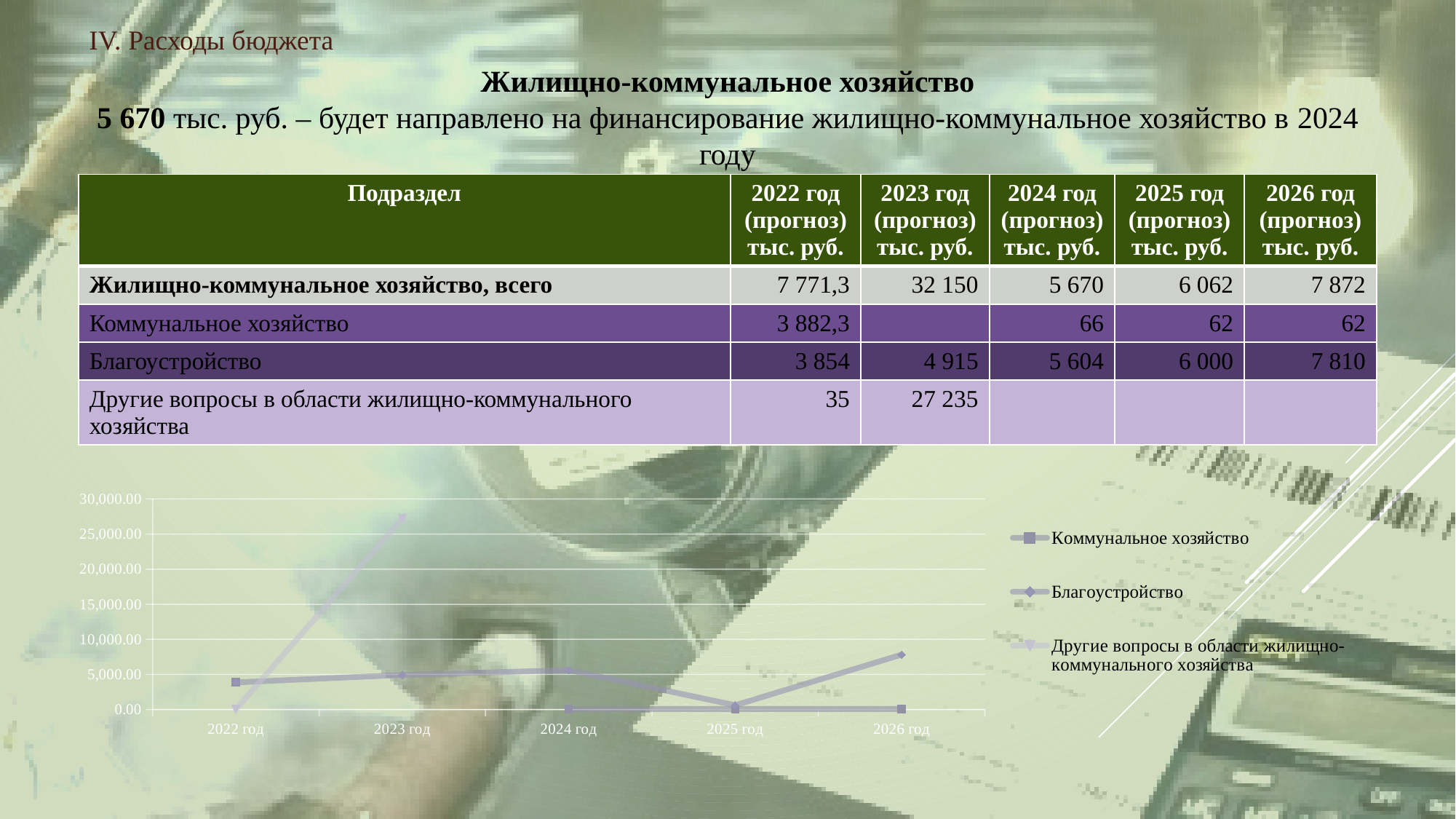
Does the Благоустройство line rise or fall from 2022 год to 2026 год? rises What is the value for Благоустройство in 2024 год, as printed in the table? 5 604 How many series does the chart legend list? 3 What marker shape does the legend use for the Коммунальное хозяйство series? square Is the value for Другие вопросы в области жилищно-коммунального хозяйства in 2023 год greater or less than 25,000.00? greater How many years are shown along the x axis of the chart? 5 What kind of chart is shown at the bottom of the slide? line chart Is the value for Коммунальное хозяйство in 2022 год greater or less than 5,000.00? less Is the value for Благоустройство in 2026 год greater or less than 10,000.00? less In 2023 год, which series has the larger value: Благоустройство or Другие вопросы в области жилищно-коммунального хозяйства? Другие вопросы в области жилищно-коммунального хозяйства By how much does the Благоустройство value in 2026 год exceed its value in 2025 год, using the table figures? 1 810 In which year does the Благоустройство line reach its highest value? 2026 год